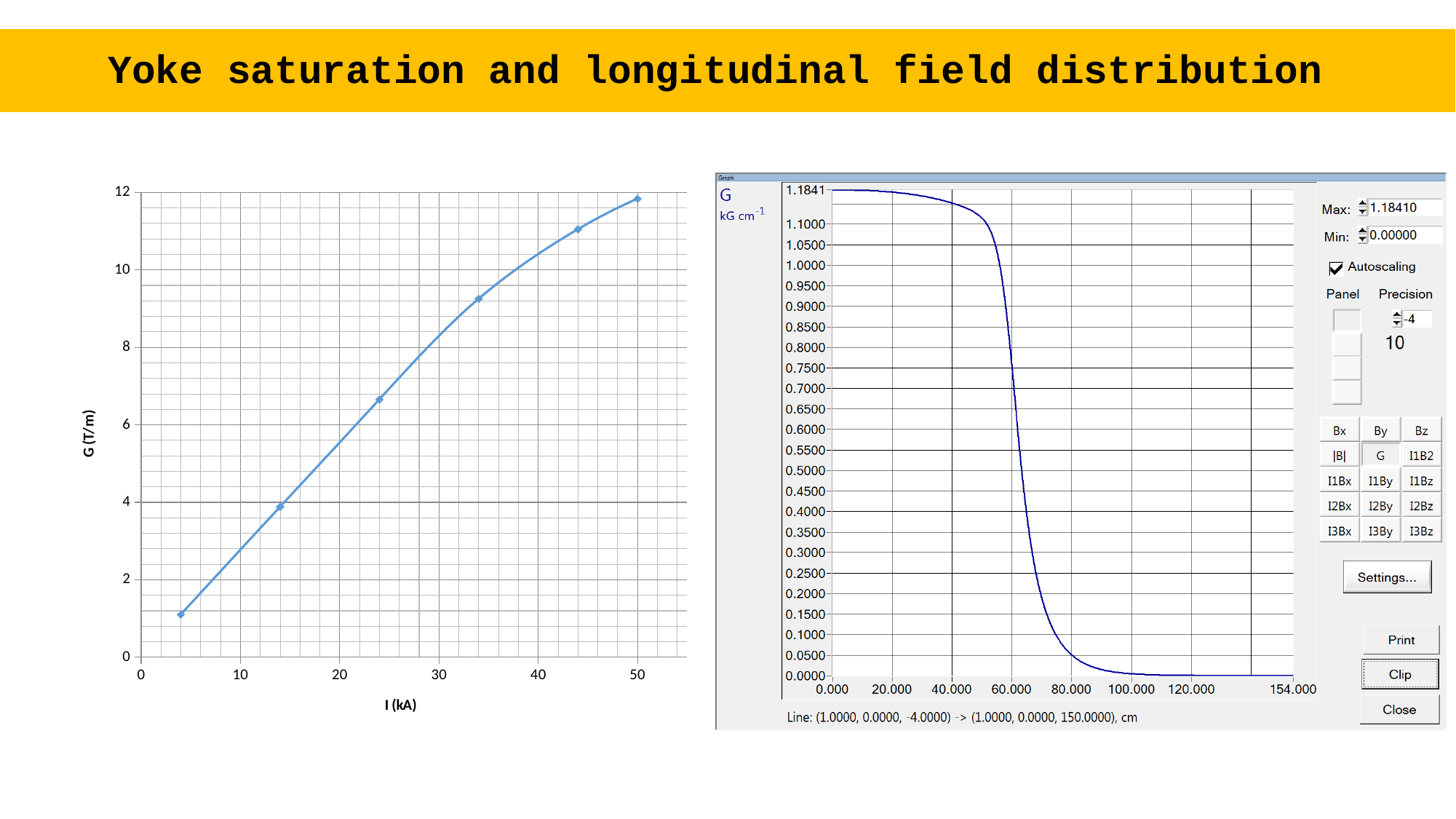
On the left chart, how many data points are plotted? 6 On the left chart, is the value of G at I = 34 kA greater or less than 8? greater On the left chart, what is the label of the y axis? G (T/m) On the left chart, what type of chart is shown? line chart On the left chart, is the value of G at I = 50 kA greater or less than 10? greater On the left chart, do the values of G rise or fall as I increases? rise On the right chart, what is the maximum value shown in the Max field? 1.18410 On the right chart, is the value of G at 40.000 cm greater or less than 1.0000? greater On the right chart, does the curve rise or fall along the x axis? fall